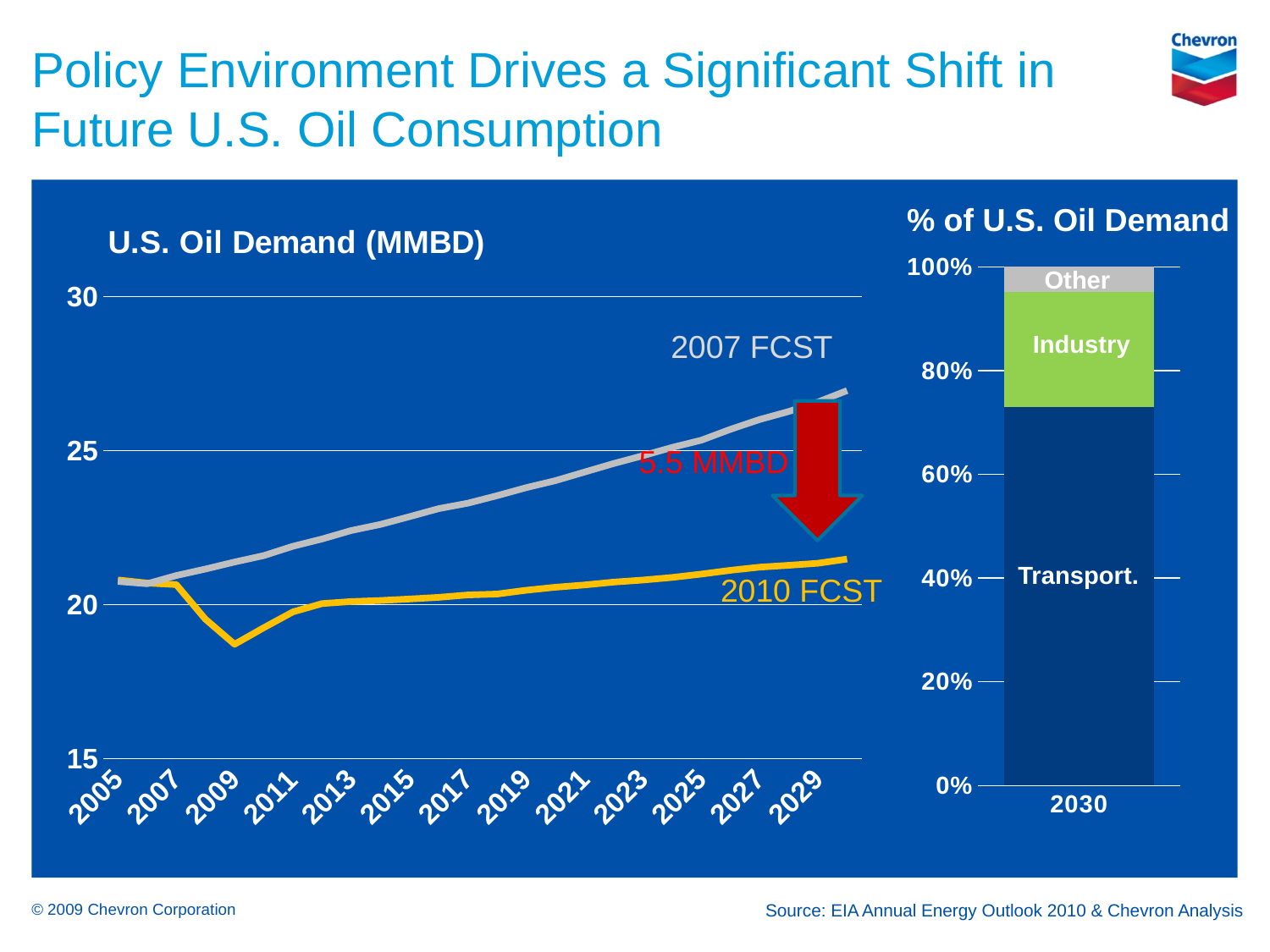
What kind of chart is the 'U.S. Oil Demand (MMBD)' chart on the left? line chart In the 'U.S. Oil Demand (MMBD)' chart, which forecast is higher in 2029, 2007 FCST or 2010 FCST? 2007 FCST In the '% of U.S. Oil Demand' chart, is the Transport. share greater or less than 60%? greater In the 'U.S. Oil Demand (MMBD)' chart, what gap between the 2007 and 2010 forecasts is labelled next to the red arrow? 5.5 MMBD In the 'U.S. Oil Demand (MMBD)' chart, how many forecast lines are plotted? 2 In the 'U.S. Oil Demand (MMBD)' chart, is the 2007 FCST value in 2029 greater or less than 25? greater In the 'U.S. Oil Demand (MMBD)' chart, how many year labels are shown on the x axis? 13 In the 'U.S. Oil Demand (MMBD)' chart, is the 2010 FCST value in 2009 greater or less than 20? less What kind of chart is the '% of U.S. Oil Demand' chart on the right? stacked bar chart In the 'U.S. Oil Demand (MMBD)' chart, does the 2007 FCST line rise or fall from 2005 to 2029? rise In the '% of U.S. Oil Demand' chart, which segment is the largest? Transport.